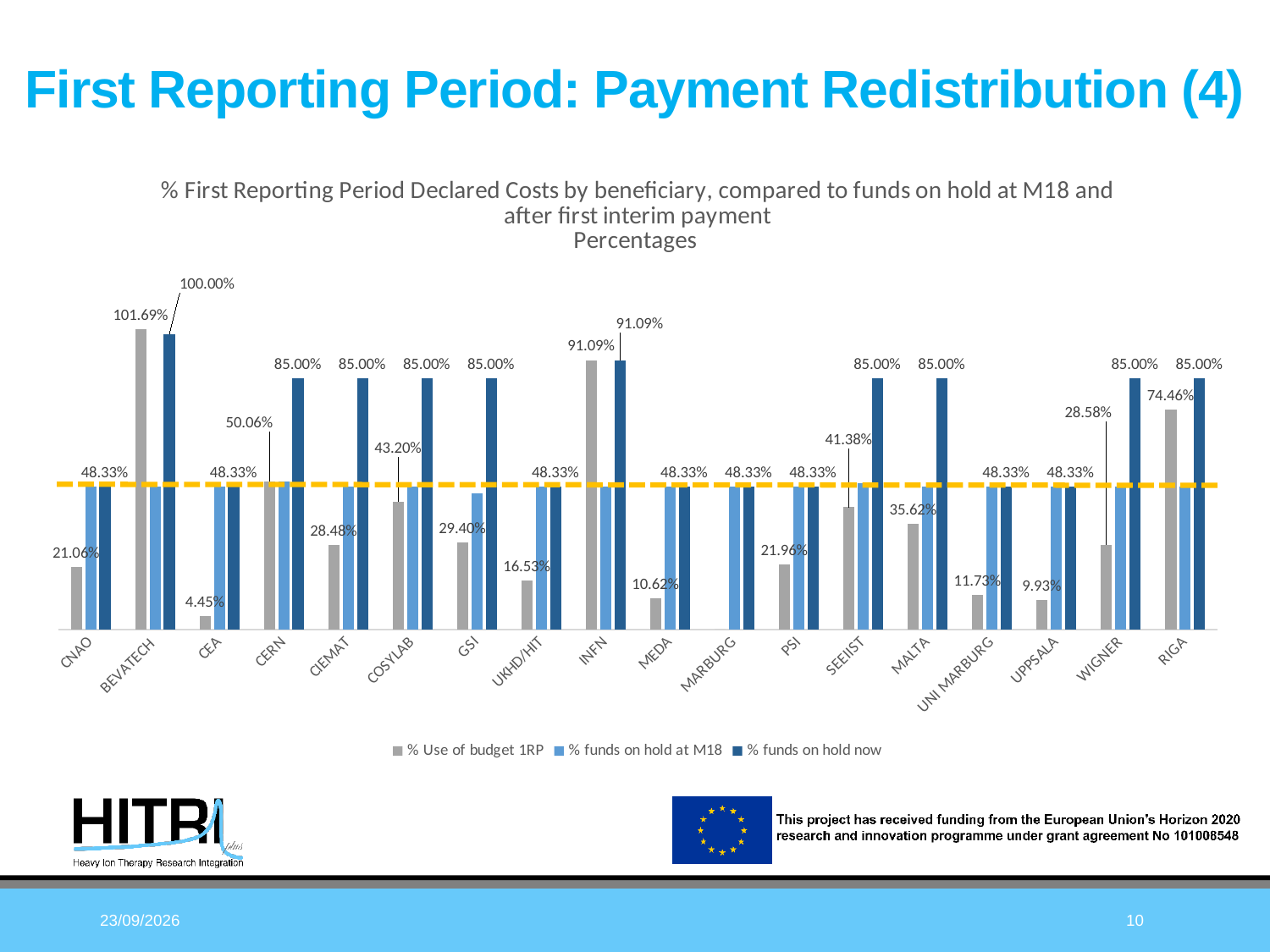
What is the % Use of budget 1RP value for BEVATECH? 101.69% Which beneficiary has the highest % Use of budget 1RP? BEVATECH What are the three series named in the legend? % Use of budget 1RP, % funds on hold at M18, % funds on hold now How many series does the legend list? 3 How many beneficiaries are shown on the x axis? 18 What kind of chart is shown on the slide? Bar chart What is the % Use of budget 1RP value for UPPSALA? 9.93% Which has a higher % Use of budget 1RP, CERN or COSYLAB? CERN What is the % Use of budget 1RP value for RIGA? 74.46% What is the difference between the % Use of budget 1RP for RIGA and for CNAO? 53.40% What is the difference between the % Use of budget 1RP for BEVATECH and for CEA? 97.24%